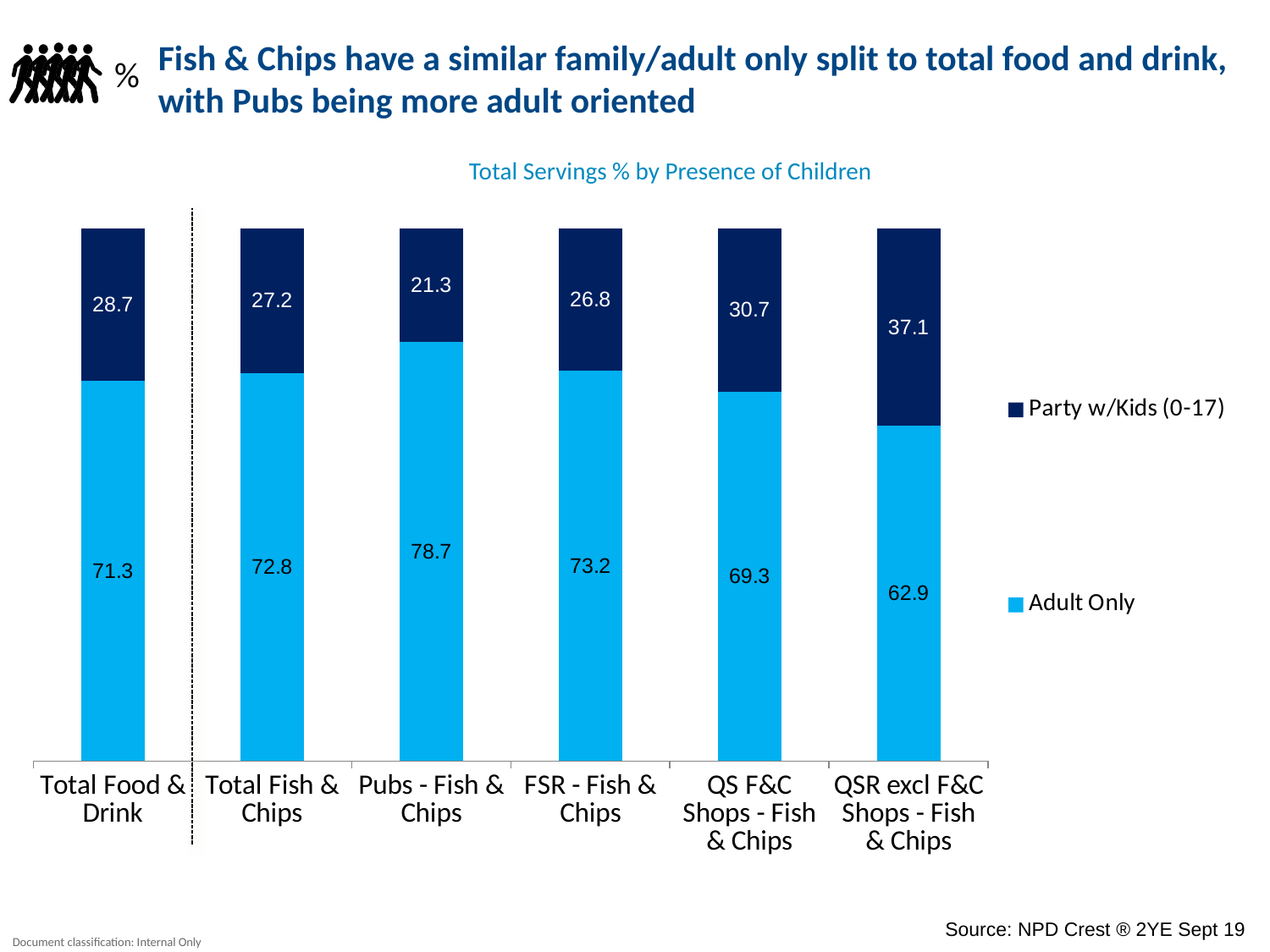
Which category has the lowest Party w/Kids (0-17) value? Pubs - Fish & Chips What is the Adult Only value for Pubs - Fish & Chips? 78.7 How many categories are shown on the x axis? 6 What is the title of the chart? Total Servings % by Presence of Children Which is larger: the Party w/Kids (0-17) value for Total Food & Drink or for FSR - Fish & Chips? Total Food & Drink What is the Adult Only value for Total Food & Drink? 71.3 What kind of chart is shown? Stacked bar chart What is the difference between the Adult Only values for Total Fish & Chips and QSR excl F&C Shops - Fish & Chips? 9.9 What is the Party w/Kids (0-17) value for QSR excl F&C Shops - Fish & Chips? 37.1 What is the Party w/Kids (0-17) value for QS F&C Shops - Fish & Chips? 30.7 How many series does the legend list? 2 Which category has the highest Adult Only value? Pubs - Fish & Chips